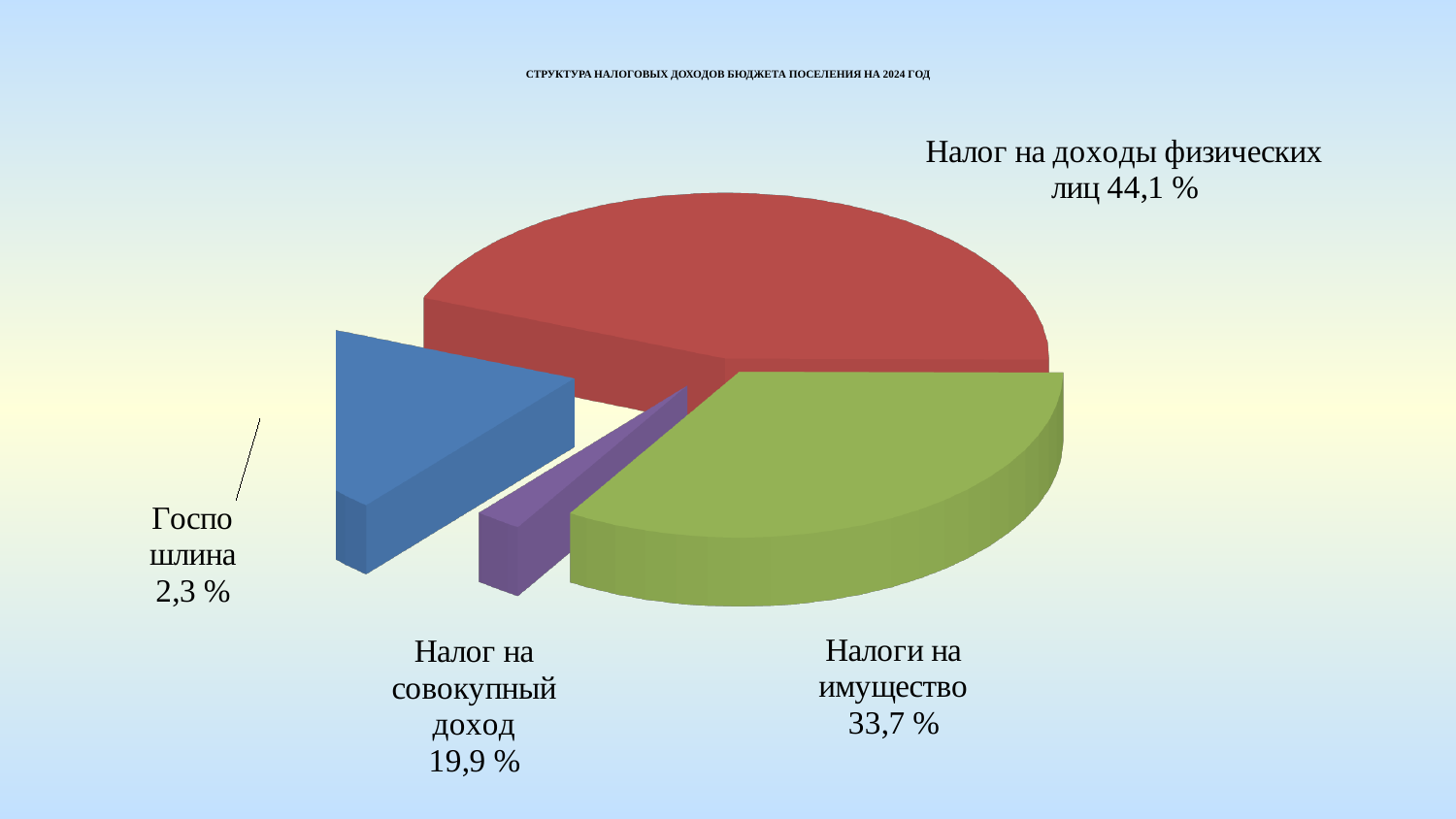
What is the difference in percentage points between Налог на доходы физических лиц and Налоги на имущество? 10,4 What is the title of the chart? СТРУКТУРА НАЛОГОВЫХ ДОХОДОВ БЮДЖЕТА ПОСЕЛЕНИЯ НА 2024 ГОД How many slices does the pie chart have? 4 Which category has the largest share of the pie? Налог на доходы физических лиц Which is larger, the share for Налоги на имущество or the share for Налог на совокупный доход? Налоги на имущество What kind of chart is shown on the slide? Pie chart Which category has the smallest share of the pie? Госпошлина What is the share for Госпошлина? 2,3 % What is the share for Налог на совокупный доход? 19,9 % What is the share for Налог на доходы физических лиц? 44,1 % What is the share for Налоги на имущество? 33,7 % What colour is the slice for Налоги на имущество? Green